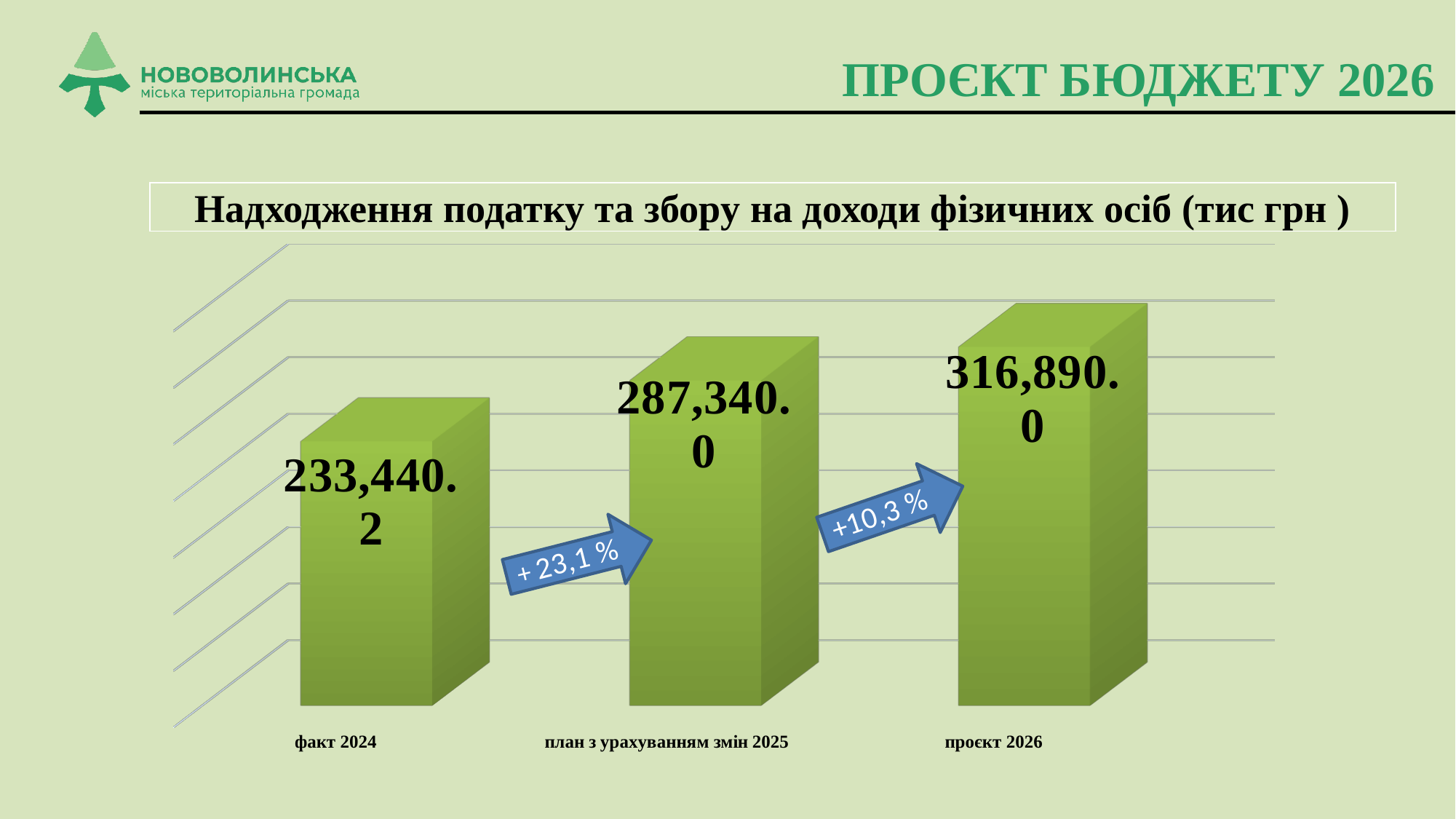
How many categories are shown in the chart? 3 Which category has the highest value? проєкт 2026 What is the value for проєкт 2026? 316,890.0 What is the value for план з урахуванням змін 2025? 287,340.0 What kind of chart is shown on the slide? bar chart Which is larger, the value for факт 2024 or the value for проєкт 2026? проєкт 2026 What is the difference between the values for план з урахуванням змін 2025 and факт 2024? 53,899.8 Which category has the lowest value? факт 2024 What is the value for факт 2024? 233,440.2 What percentage change is shown on the arrow between план з урахуванням змін 2025 and проєкт 2026? +10,3 % What is the difference between the values for проєкт 2026 and план з урахуванням змін 2025? 29,550.0 Do the values rise or fall from факт 2024 to проєкт 2026? rise